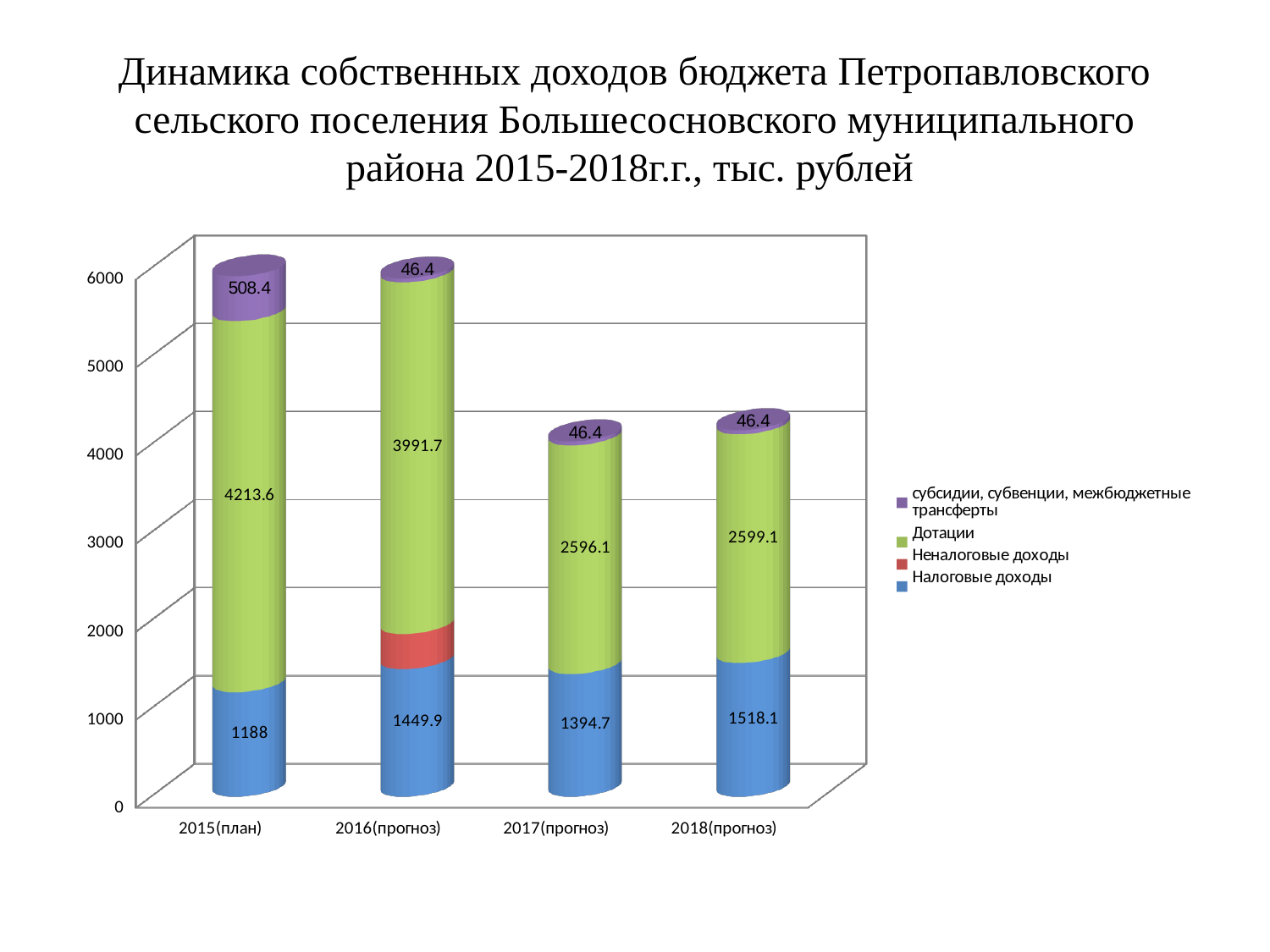
What is the value of Налоговые доходы for 2018(прогноз)? 1518.1 Is the total height of the 2016(прогноз) bar greater or less than 5000? greater What is the value of субсидии, субвенции, межбюджетные трансферты for 2015(план)? 508.4 What is the difference between Налоговые доходы in 2018(прогноз) and in 2015(план)? 330.1 What is the total of the stacked bar for 2015(план)? 5910 In which year is the value of Налоговые доходы the lowest? 2015(план) What is the value of Налоговые доходы for 2015(план)? 1188 Which is larger: Дотации in 2017(прогноз) or in 2018(прогноз)? 2018(прогноз) What is the value of Дотации for 2016(прогноз)? 3991.7 What kind of chart is shown on the slide? Stacked bar chart How many series does the legend list? 4 In which year is the value of Дотации the highest? 2015(план)